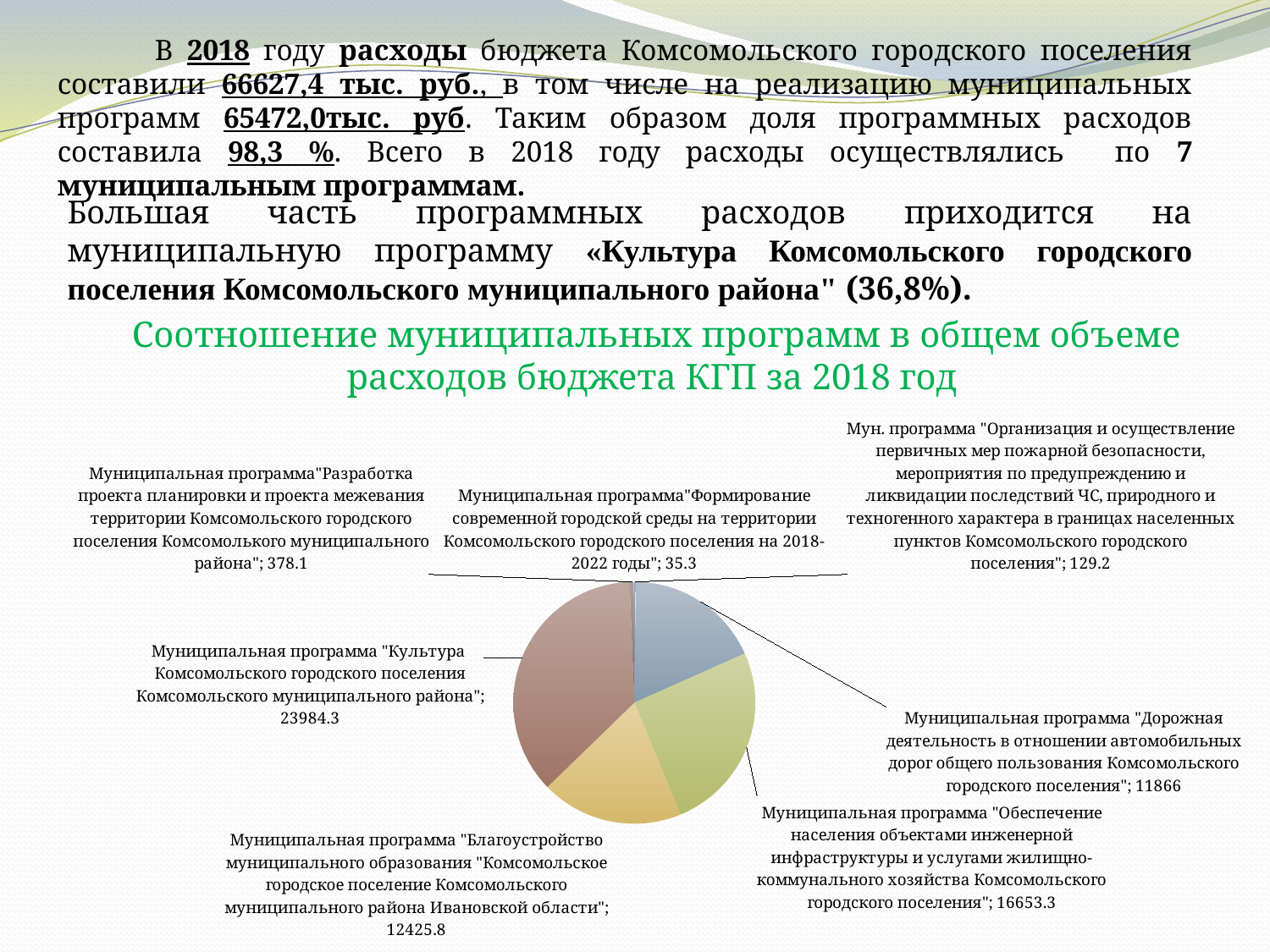
What is the value shown for the program "Культура Комсомольского городского поселения Комсомольского муниципального района"? 23984.3 What is the difference between the values for the "Культура" program and the "Обеспечение населения объектами инженерной инфраструктуры" program? 7331.0 What type of chart is shown on the slide? pie chart Which municipal program has the largest slice in the pie chart? Муниципальная программа "Культура Комсомольского городского поселения Комсомольского муниципального района" Which is larger: the value for the "Благоустройство" program or the value for the "Дорожная деятельность" program? Благоустройство (12425.8) What is the value shown for the program "Благоустройство муниципального образования "Комсомольское городское поселение Комсомольского муниципального района Ивановской области"? 12425.8 What is the value shown for the program "Формирование современной городской среды на территории Комсомольского городского поселения на 2018-2022 годы"? 35.3 What is the difference between the values for the "Разработка проекта планировки и проекта межевания" program and the "Организация и осуществление первичных мер пожарной безопасности" program? 248.9 What is the value shown for the program "Дорожная деятельность в отношении автомобильных дорог общего пользования Комсомольского городского поселения"? 11866 Which municipal program has the smallest slice in the pie chart? Муниципальная программа "Формирование современной городской среды на территории Комсомольского городского поселения на 2018-2022 годы" What is the title of the pie chart? Соотношение муниципальных программ в общем объеме расходов бюджета КГП за 2018 год How many slices (municipal programs) does the pie chart contain? 7